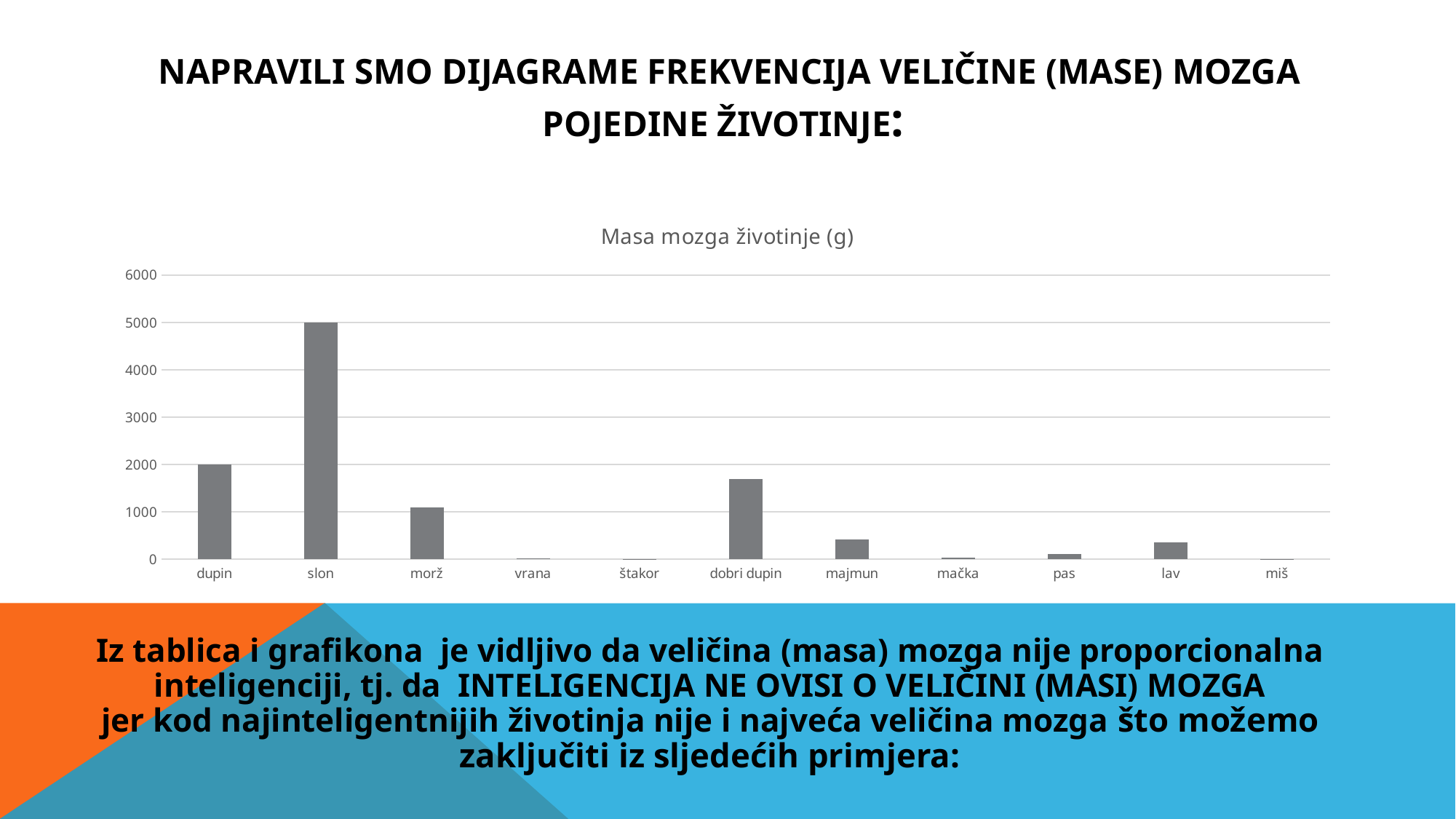
How many animal categories are shown on the x axis of the chart? 11 What is the value for slon in the chart? 5000 Which animal has the highest brain mass in the chart? slon Is the value for dobri dupin greater or less than 2000? less Which has a larger value, lav or pas? lav Which has a larger value, dupin or dobri dupin? dupin What is the value for dupin in the chart? 2000 Is the value for majmun greater or less than 1000? less What is the difference between the values for slon and dupin? 3000 Is the value for morž greater or less than 1000? greater What kind of chart is shown on the slide? bar chart What is the title of the chart? Masa mozga životinje (g)